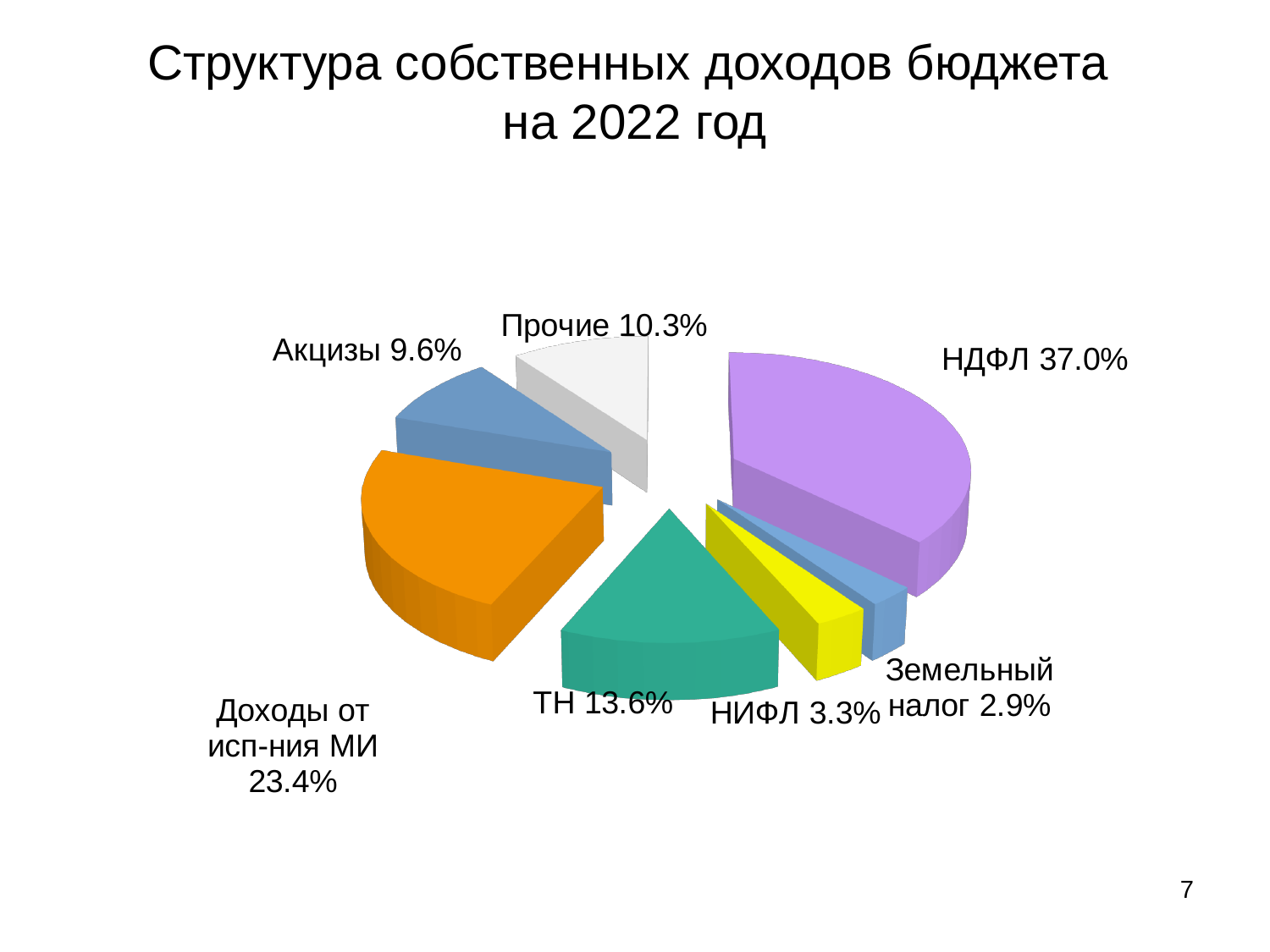
What share of the pie does Доходы от исп-ния МИ have? 23.4% Which category has the largest share of the pie? НДФЛ What is the difference between the share for НИФЛ and the share for Земельный налог? 0.4% What share of the pie does Земельный налог have? 2.9% Which category has the smallest share of the pie? Земельный налог What share of the pie does ТН have? 13.6% What is the difference between the share for НДФЛ and the share for Доходы от исп-ния МИ? 13.6% What is the title of the chart? Структура собственных доходов бюджета на 2022 год What share of the pie does НДФЛ have? 37.0% How many slices does the pie chart have? 7 Which is larger, the share for Акцизы or the share for Прочие? Прочие What kind of chart is shown on the slide? pie chart